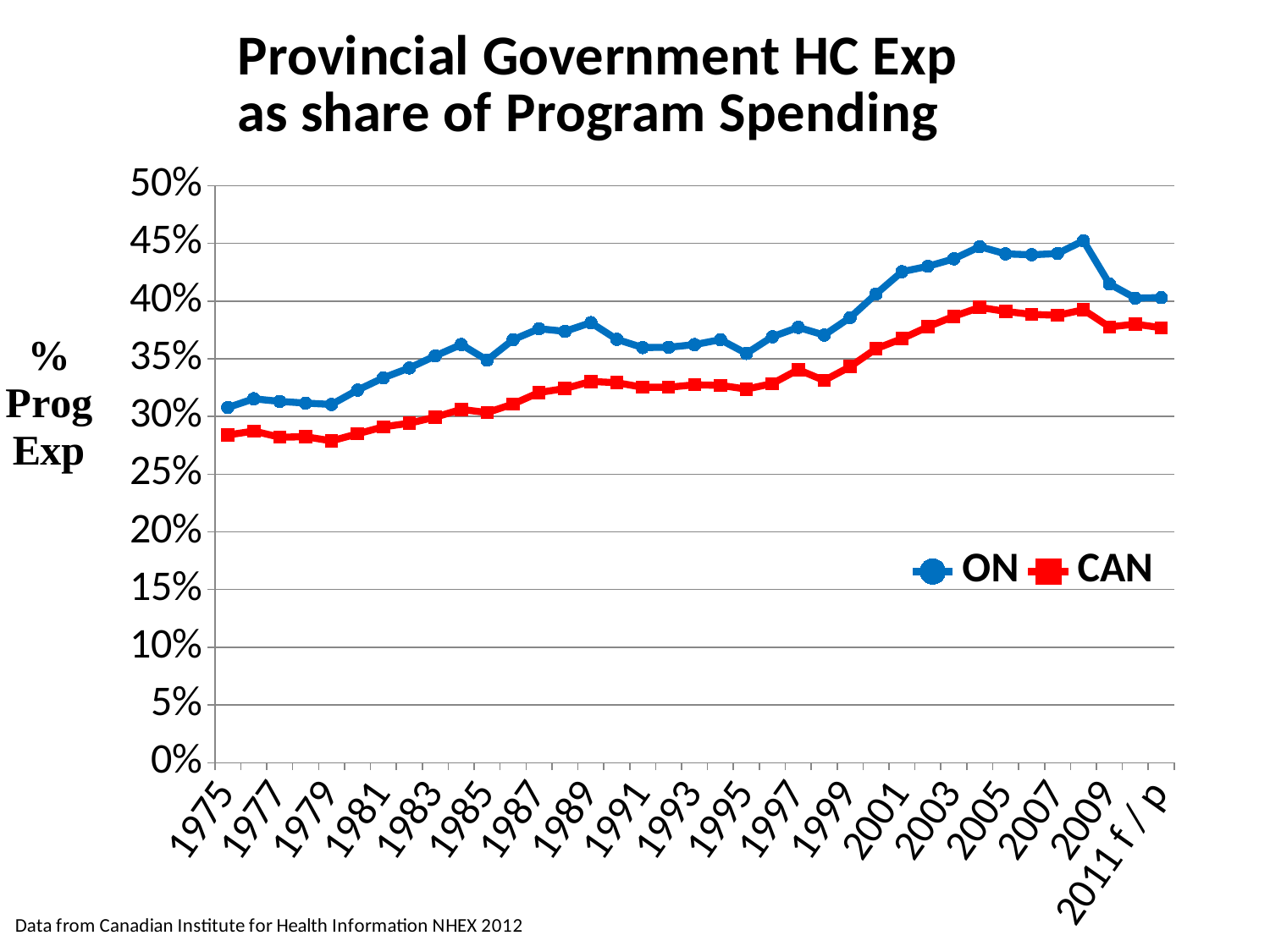
Does the ON series rise or fall from 2009 to 2011 f / p? fall Does the ON series generally rise or fall from 1975 to 2009? rise What are the two series named in the legend? ON and CAN In 2005, which series has the larger value, ON or CAN? ON Which series is plotted higher across the whole period, ON or CAN? ON What kind of chart is shown on the slide? line chart What is the title of the chart? Provincial Government HC Exp as share of Program Spending Is the value for ON in 2003 greater or less than 40%? greater Is the value for ON in 2009 greater or less than 40%? greater How many series does the legend list? 2 Is the value for CAN in 2005 greater or less than 35%? greater